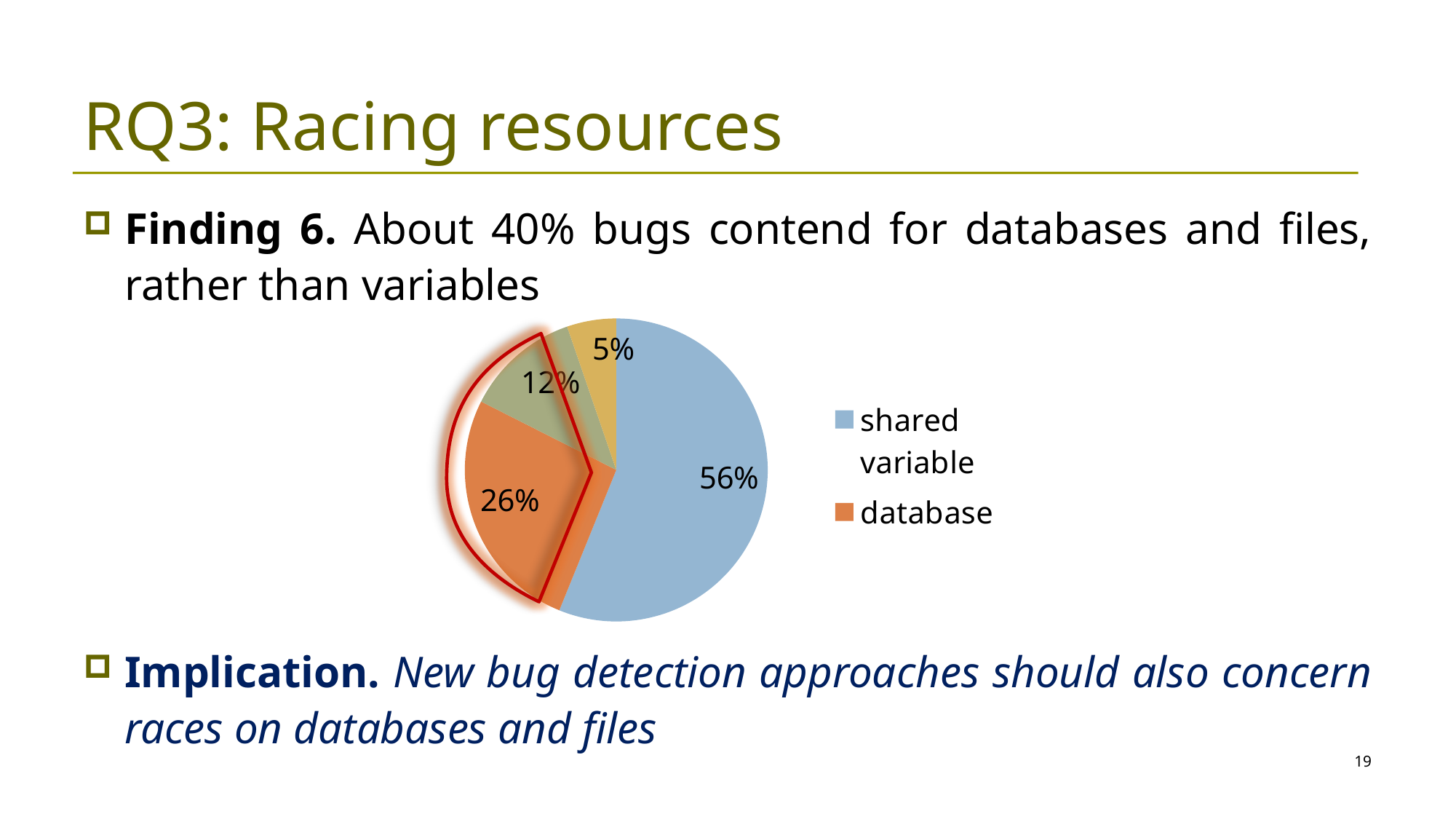
Is the database slice more or less than half of the pie? less What share of the pie does the database slice represent? 26% How many slices does the pie chart have? 4 What kind of chart is shown on the slide? pie chart What percentage of the pie chart is labelled for database? 26% By how many percentage points does the shared variable slice exceed the database slice? 30 percentage points What percentage of the pie chart is labelled for shared variable? 56% What colour is the shared variable slice in the pie chart? blue What is the smallest percentage printed on the pie chart? 5% Which is larger in the pie chart, shared variable or database? shared variable Which category has the largest slice in the pie chart? shared variable How many entries are listed in the chart's legend? 2